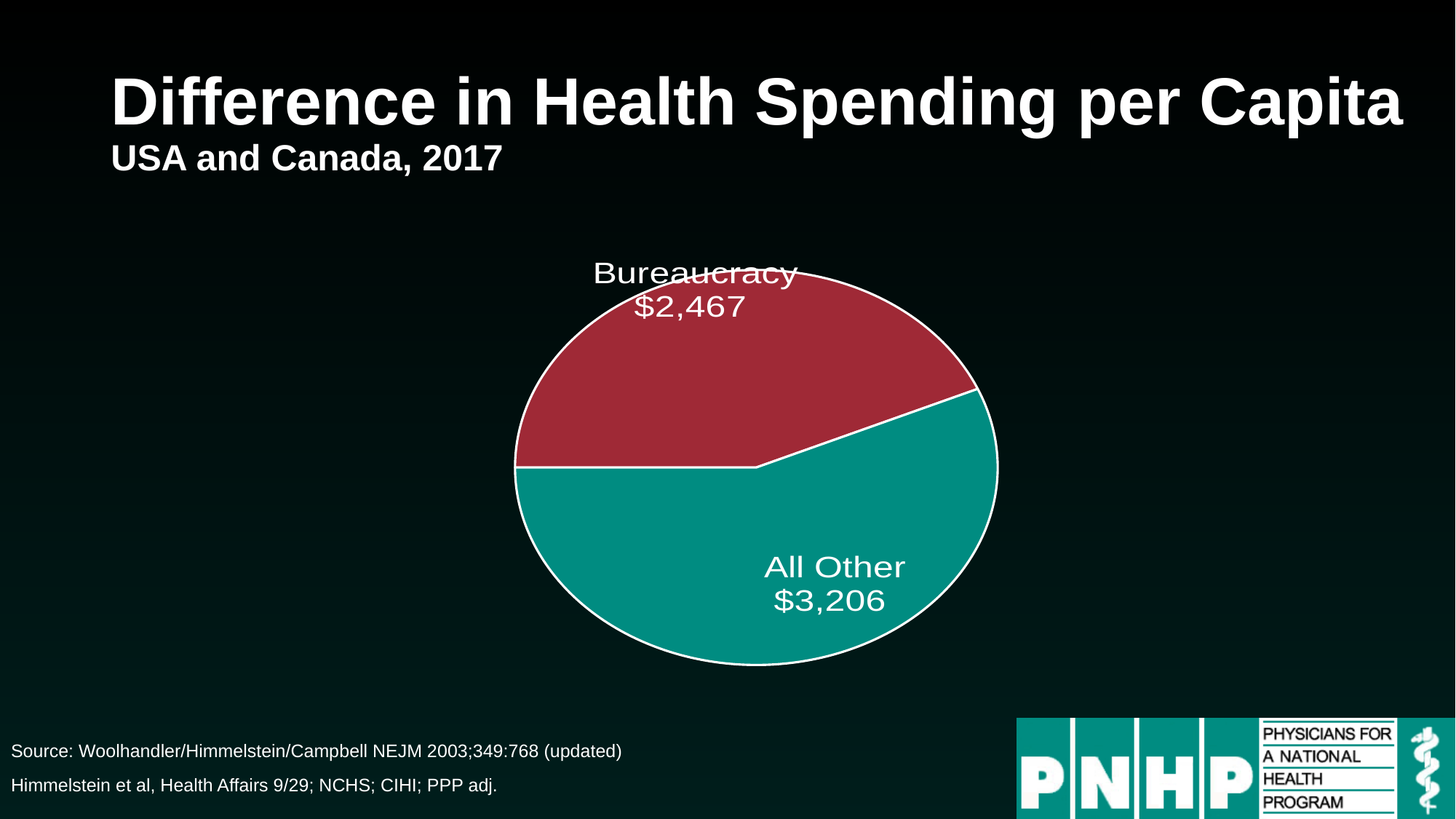
Which slice of the pie is the largest? All Other What is the difference between the All Other value and the Bureaucracy value? $739 What is the title of the slide containing the chart? Difference in Health Spending per Capita What kind of chart is shown on the slide? Pie chart Which is larger, the Bureaucracy value or the All Other value? All Other What is the total of the two slices in the pie chart? $5,673 What is the value shown for the Bureaucracy slice? $2,467 Which slice of the pie is the smallest? Bureaucracy What colour is the All Other slice? Teal How many slices does the pie chart have? 2 What is the value shown for the All Other slice? $3,206